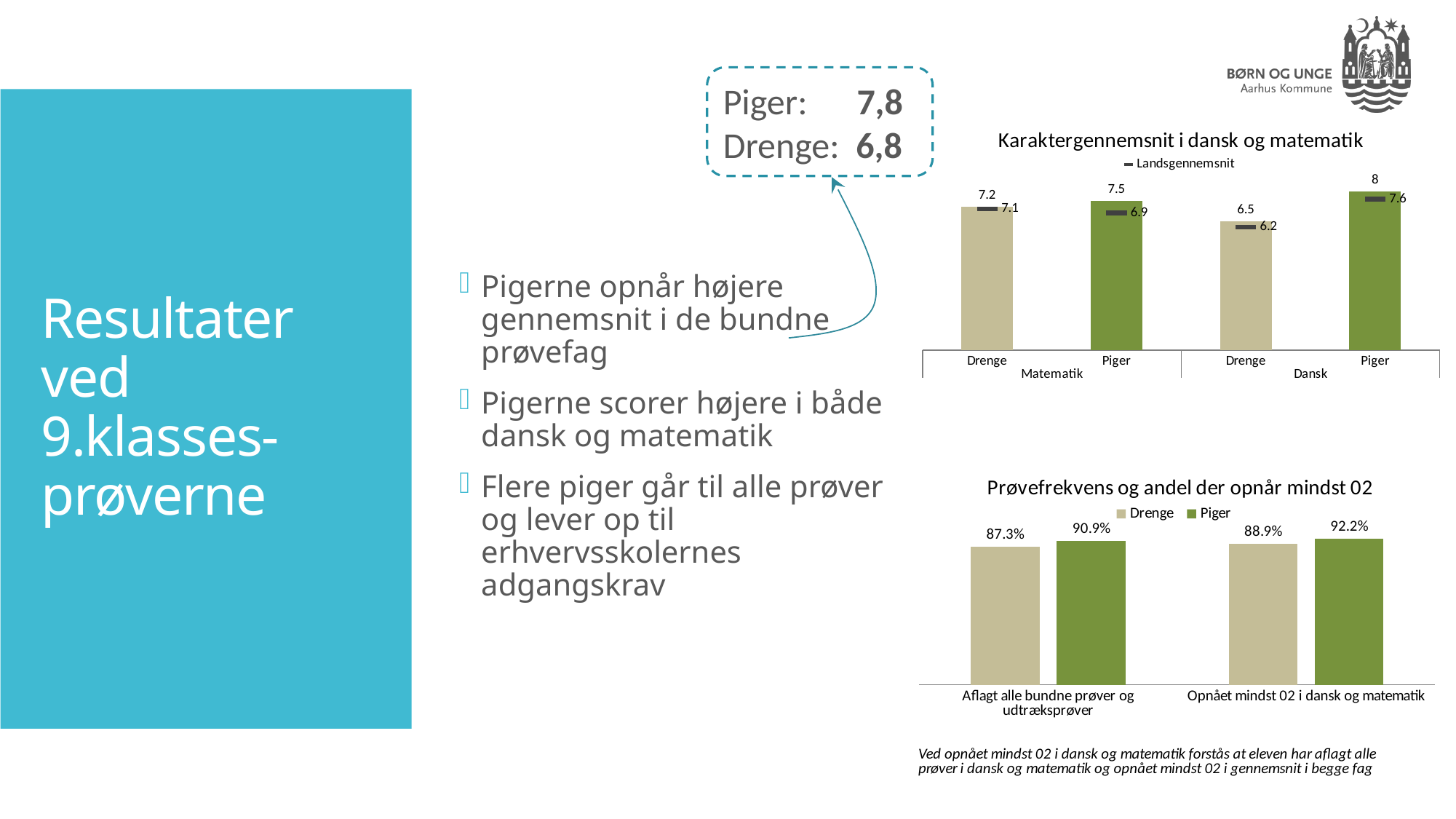
In the chart 'Karaktergennemsnit i dansk og matematik', what is the value for Piger in Dansk? 8 In the chart 'Prøvefrekvens og andel der opnår mindst 02', what is the value for Drenge in 'Aflagt alle bundne prøver og udtræksprøver'? 87.3% In the chart 'Karaktergennemsnit i dansk og matematik', what is the value for Drenge in Matematik? 7.2 What kind of chart is 'Prøvefrekvens og andel der opnår mindst 02'? Bar chart In the chart 'Karaktergennemsnit i dansk og matematik', what is the Landsgennemsnit marker value for Drenge in Dansk? 6.2 In the chart 'Karaktergennemsnit i dansk og matematik', what is the difference between Piger and Drenge in Dansk? 1.5 In the chart 'Karaktergennemsnit i dansk og matematik', how many bars are plotted? 4 In the chart 'Prøvefrekvens og andel der opnår mindst 02', what is the difference between Piger and Drenge for 'Aflagt alle bundne prøver og udtræksprøver'? 3.6% In the chart 'Karaktergennemsnit i dansk og matematik', which bar has the lowest value? Drenge, Dansk In the chart 'Prøvefrekvens og andel der opnår mindst 02', what is the value for Piger in 'Opnået mindst 02 i dansk og matematik'? 92.2% In the chart 'Prøvefrekvens og andel der opnår mindst 02', how many series does the legend list? 2 In the chart 'Prøvefrekvens og andel der opnår mindst 02', which bar has the highest value? Piger, Opnået mindst 02 i dansk og matematik